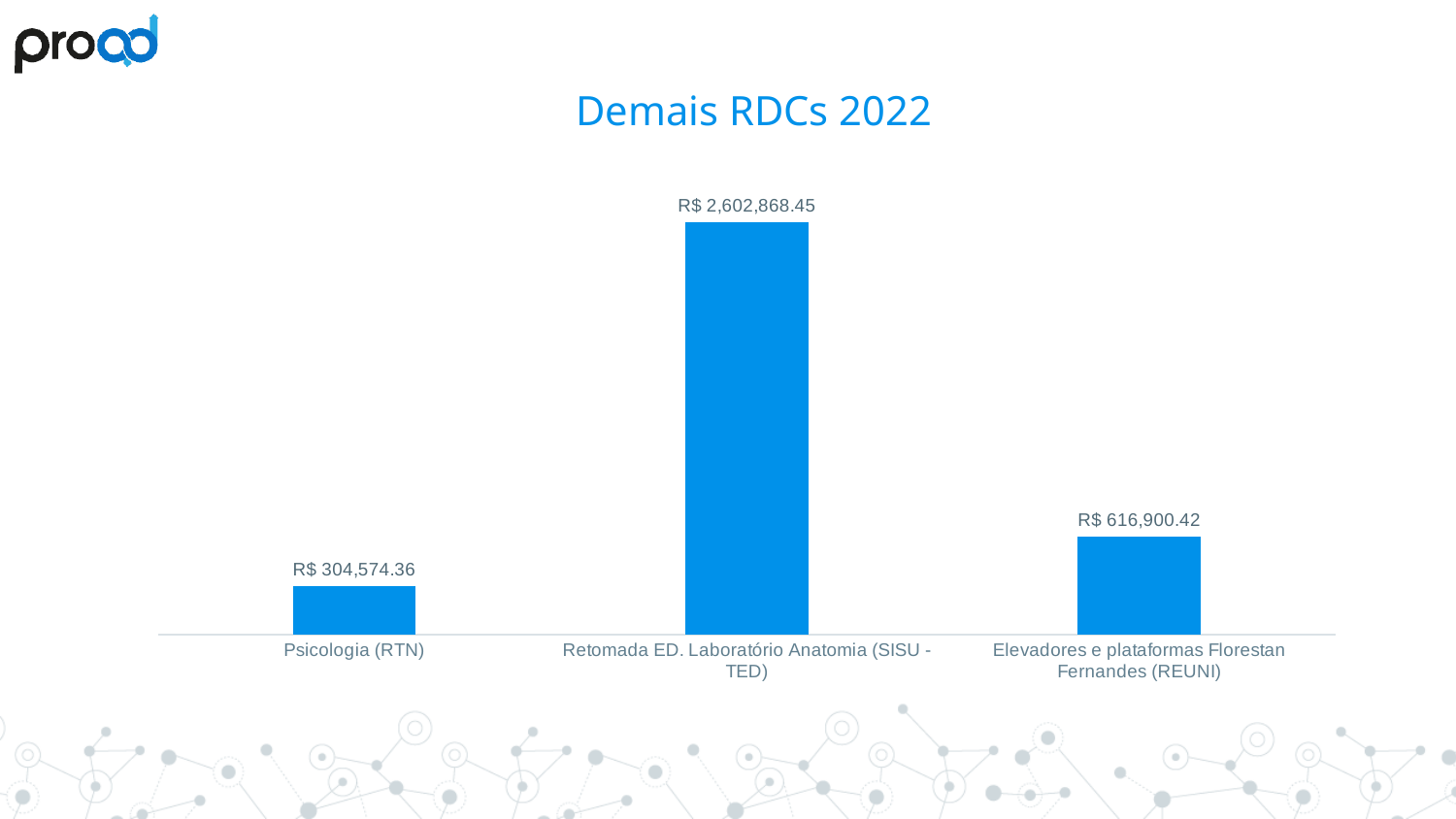
What is the value for Elevadores e plataformas Florestan Fernandes (REUNI)? R$ 616,900.42 Which category has the highest value? Retomada ED. Laboratório Anatomia (SISU - TED) What is the difference between the values for Retomada ED. Laboratório Anatomia (SISU - TED) and Psicologia (RTN)? R$ 2,298,294.09 Which category has the lowest value? Psicologia (RTN) What is the difference between the values for Elevadores e plataformas Florestan Fernandes (REUNI) and Psicologia (RTN)? R$ 312,326.06 What is the value for Psicologia (RTN)? R$ 304,574.36 Which is larger, the value for Elevadores e plataformas Florestan Fernandes (REUNI) or the value for Psicologia (RTN)? Elevadores e plataformas Florestan Fernandes (REUNI) How many categories are shown in the chart? 3 What is the title of the chart? Demais RDCs 2022 What is the value for Retomada ED. Laboratório Anatomia (SISU - TED)? R$ 2,602,868.45 What is the difference between the values for Retomada ED. Laboratório Anatomia (SISU - TED) and Elevadores e plataformas Florestan Fernandes (REUNI)? R$ 1,985,968.03 What kind of chart is shown on the slide? Bar chart